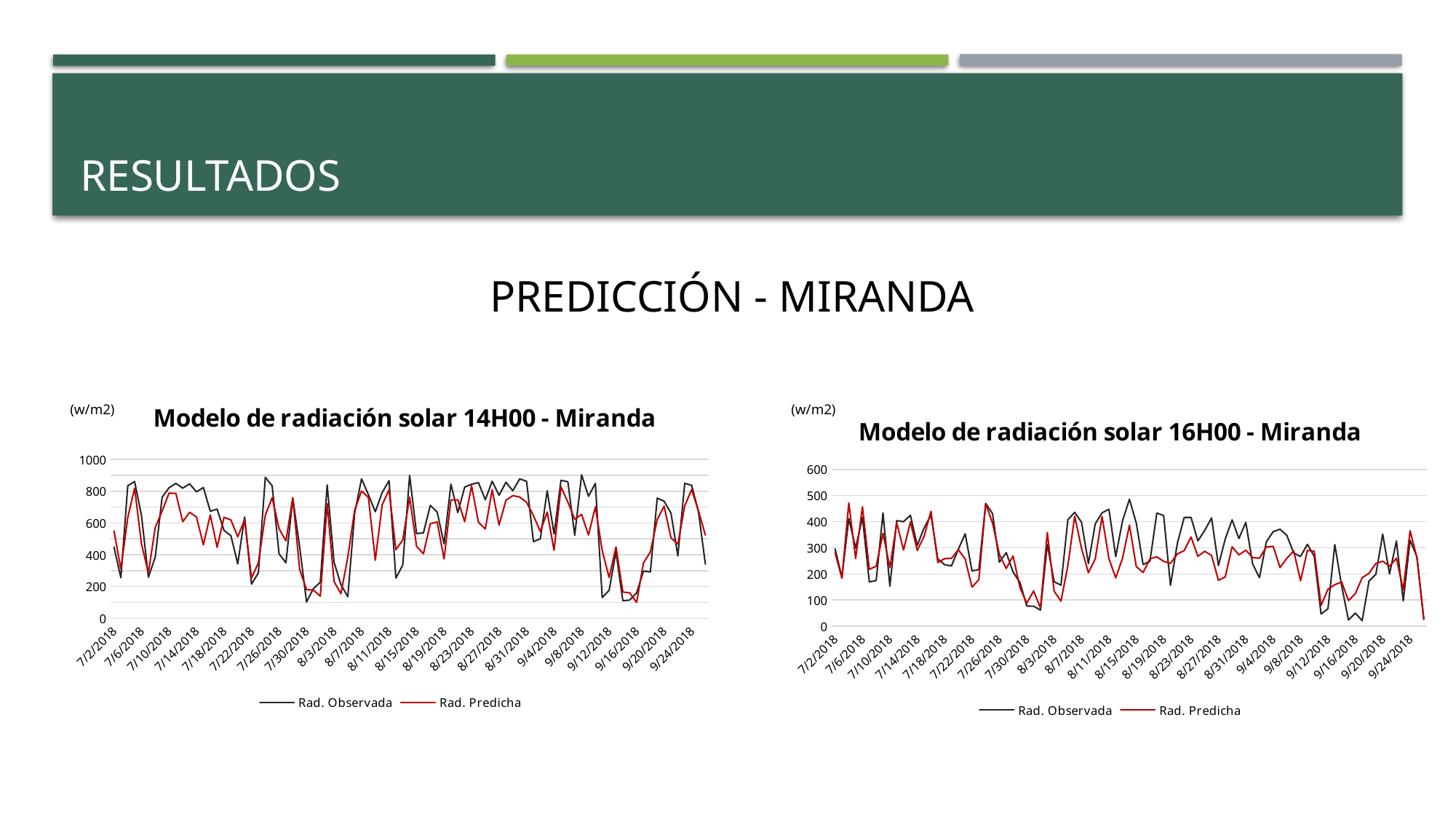
In the chart 'Modelo de radiación solar 14H00 - Miranda', how many series does the legend list? 2 In the chart 'Modelo de radiación solar 16H00 - Miranda', what are the two series named in the legend? Rad. Observada and Rad. Predicha In the chart 'Modelo de radiación solar 16H00 - Miranda', is the highest value of Rad. Observada greater or less than 400? greater In the chart 'Modelo de radiación solar 16H00 - Miranda', is the highest value of Rad. Predicha greater or less than 400? greater In the chart 'Modelo de radiación solar 16H00 - Miranda', what is the highest value shown on the y axis? 600 What kind of chart is 'Modelo de radiación solar 16H00 - Miranda'? line chart What kind of chart is 'Modelo de radiación solar 14H00 - Miranda'? line chart In the chart 'Modelo de radiación solar 14H00 - Miranda', what is the highest value shown on the y axis? 1000 In the chart 'Modelo de radiación solar 14H00 - Miranda', what colour is the Rad. Predicha line? red In the chart 'Modelo de radiación solar 14H00 - Miranda', is the lowest value of Rad. Observada greater or less than 200? less In the chart 'Modelo de radiación solar 14H00 - Miranda', what is the first date shown on the x axis? 7/2/2018